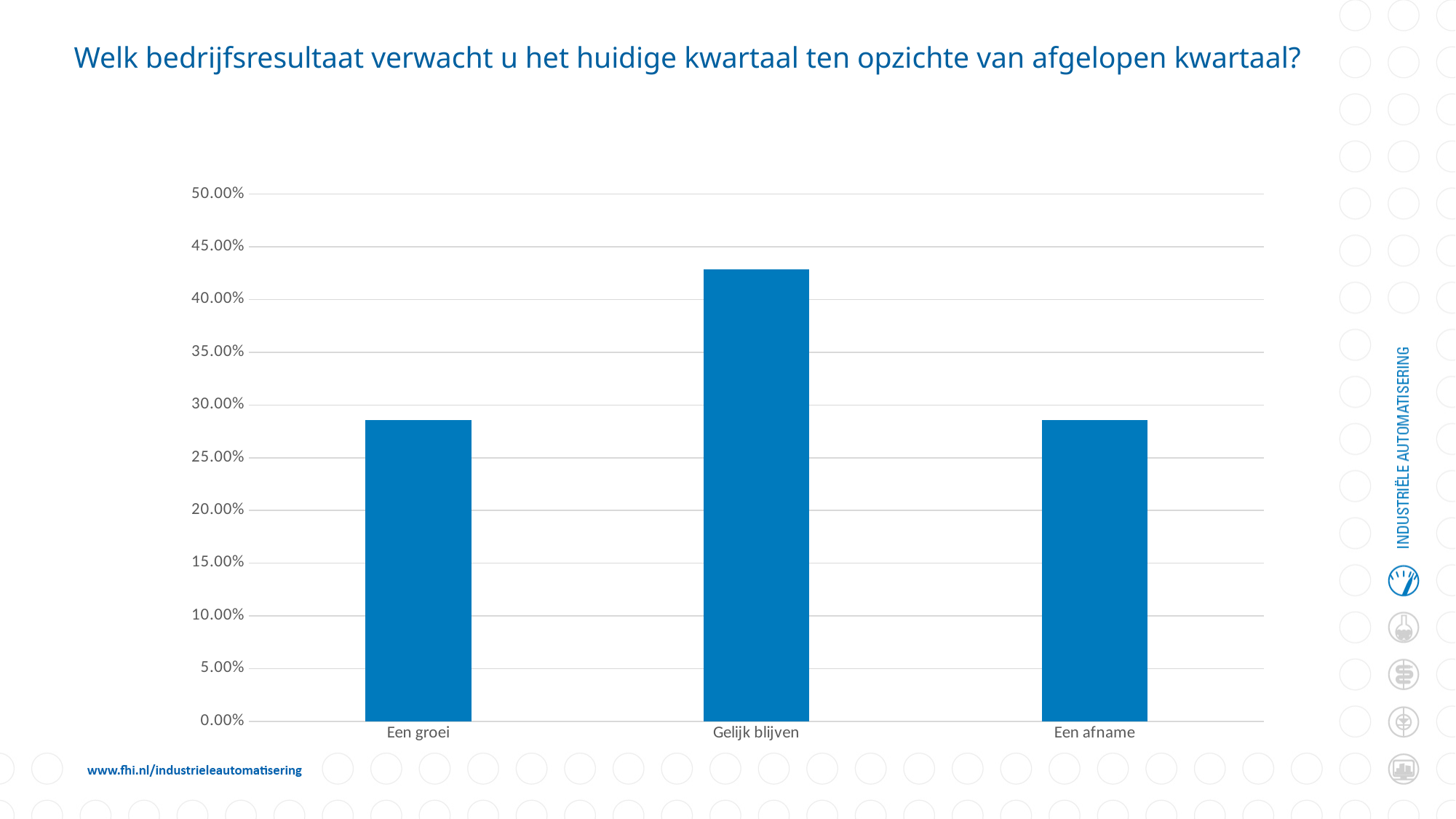
Is the value for Een afname greater or less than 30.00%? less Is the value for Een afname greater or less than 25.00%? greater Is the value for Een groei greater or less than 30.00%? less How many categories are shown on the x axis of the chart? 3 Which is larger, the value for Een afname or the value for Gelijk blijven? Gelijk blijven What kind of chart is shown on the slide? bar chart Which category has the highest value in the chart? Gelijk blijven Which is larger, the value for Gelijk blijven or the value for Een groei? Gelijk blijven What is the title of the chart on the slide? Welk bedrijfsresultaat verwacht u het huidige kwartaal ten opzichte van afgelopen kwartaal?